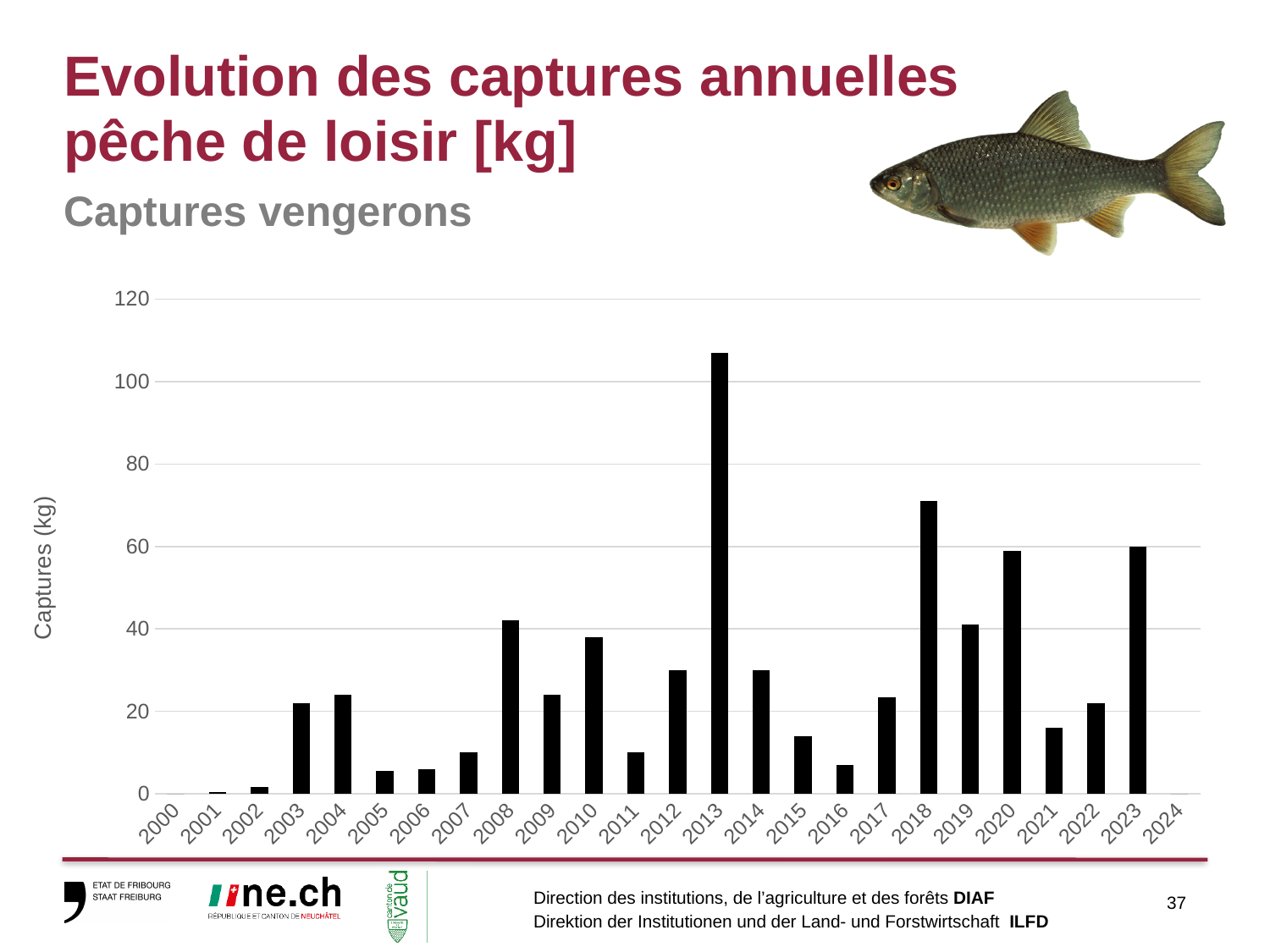
What is the label on the y axis of the chart? Captures (kg) Do the values rise or fall from 2013 to 2016? fall Is the value for 2018 greater or less than 80? less Which year has the larger value, 2013 or 2018? 2013 Which year has the larger value, 2008 or 2016? 2008 Is the value for 2005 greater or less than 20? less Which year has the highest catch value in the chart? 2013 What kind of chart is shown on the slide? bar chart Is the value for 2013 greater or less than 100? greater What is the subtitle shown above the chart? Captures vengerons How many years are shown on the x axis of the chart? 25